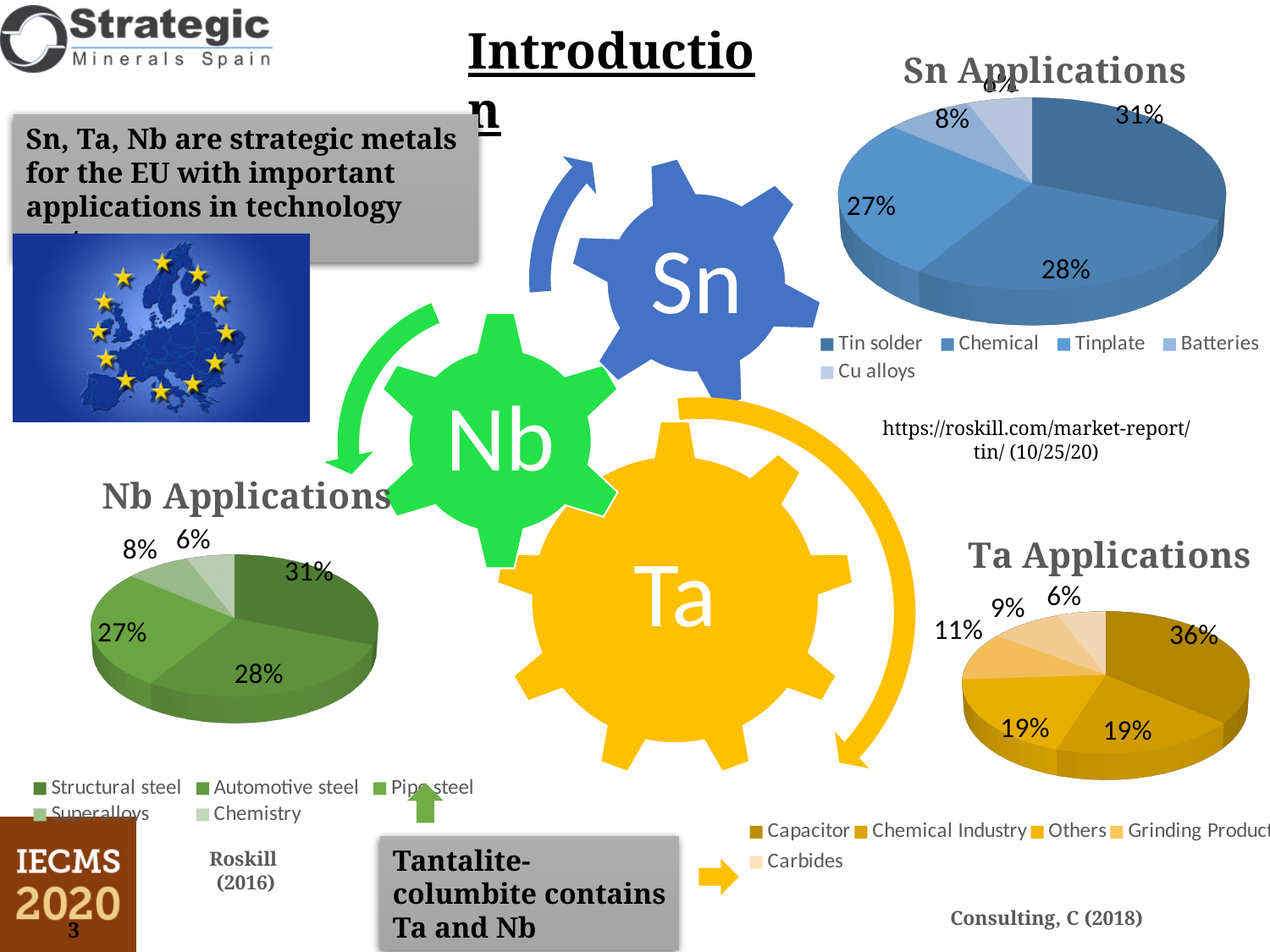
In the Nb Applications chart, what percentage is shown for Structural steel? 31% In the Nb Applications chart, which application has the smallest share? Chemistry In the Sn Applications chart, which application has the largest share? Tin solder In the Nb Applications chart, what percentage is shown for Pipe steel? 27% In the Ta Applications chart, what percentage is shown for Capacitor? 36% In the Sn Applications chart, what percentage is shown for Batteries? 8% In the Sn Applications chart, what is the difference in percentage points between Chemical and Tinplate? 1 percentage point In the Sn Applications chart, how many entries does the legend list? 5 In the Sn Applications chart, what percentage is shown for Tin solder? 31% In the Ta Applications chart, which application has the largest share? Capacitor What type of chart is used for the Sn, Nb and Ta Applications charts on this slide? Pie chart In the Nb Applications chart, which is larger, Automotive steel or Superalloys? Automotive steel